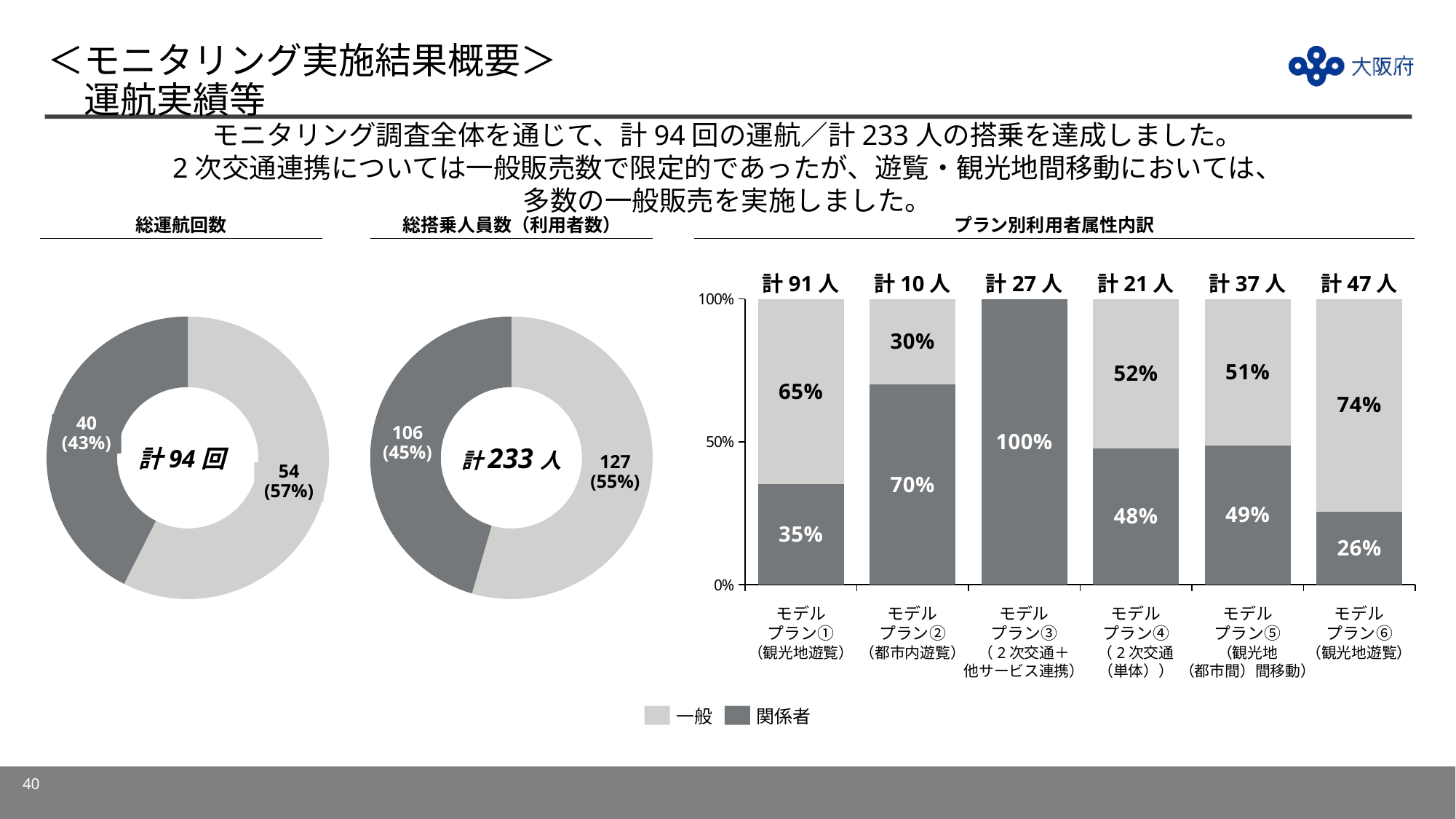
In the プラン別利用者属性内訳 chart, what is the 一般 percentage for モデルプラン⑥? 74% In the プラン別利用者属性内訳 chart, what is the 関係者 percentage for モデルプラン②? 70% How many model plans are shown on the x axis of the プラン別利用者属性内訳 chart? 6 In the 総運航回数 donut chart, what total is shown in the centre? 計94回 In the プラン別利用者属性内訳 chart, which model plan has the highest 関係者 share? モデルプラン③ In the プラン別利用者属性内訳 chart, what total number of people is shown above the bar for モデルプラン①? 計91人 In the 総運航回数 donut chart, what is the difference between the two segment values (54 and 40)? 14 How many series does the legend of the プラン別利用者属性内訳 chart list? 2 In the 総運航回数 donut chart, what value and percentage are shown for the light grey segment? 54 (57%) In the プラン別利用者属性内訳 chart, which model plan has the lowest 関係者 share? モデルプラン⑥ In the プラン別利用者属性内訳 chart, which model plan has the smallest total number of people shown above its bar? モデルプラン② (計10人) In the 総搭乗人員数（利用者数） donut chart, what value and percentage are shown for the dark grey segment? 106 (45%)